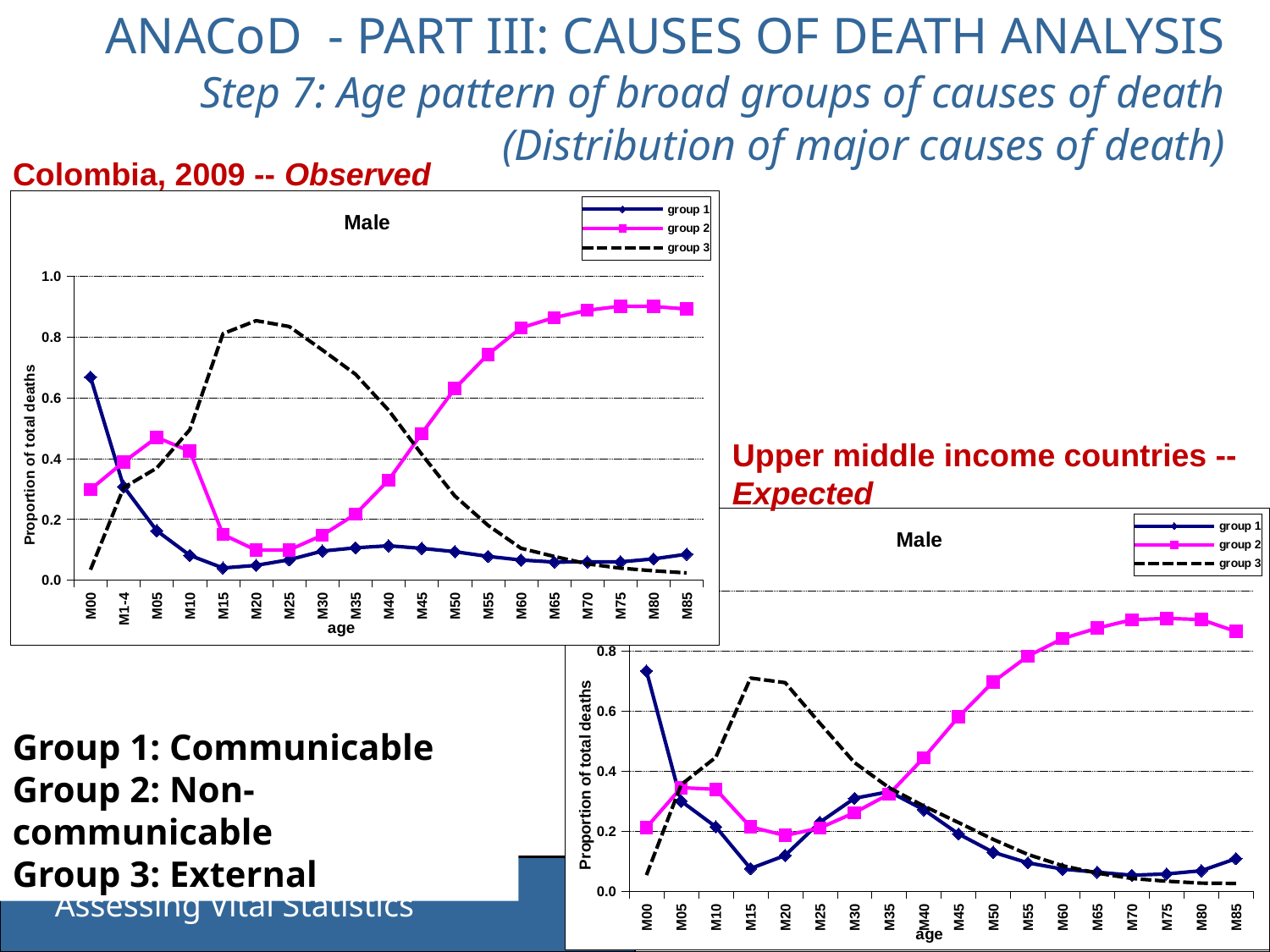
How many series does the legend of the Colombia, 2009 -- Observed chart list? 3 In the Colombia, 2009 -- Observed chart, which series has the larger value at M20: group 2 or group 3? group 3 In the Upper middle income countries -- Expected chart, is the group 3 value at M15 greater or less than 0.6? greater In the Colombia, 2009 -- Observed chart, is the group 1 value at M00 greater or less than 0.6? greater What kind of chart is the Colombia, 2009 -- Observed chart? line chart In the Upper middle income countries -- Expected chart, does the group 2 series generally rise or fall from M25 to M75? rise In the Colombia, 2009 -- Observed chart, at which age category is the group 1 value highest? M00 What is the y-axis label of the Colombia, 2009 -- Observed chart? Proportion of total deaths In the Colombia, 2009 -- Observed chart, is the group 2 value at M85 greater or less than 0.8? greater In the Upper middle income countries -- Expected chart, which series has the larger value at M60: group 1 or group 2? group 2 How many age categories are shown on the x axis of the Upper middle income countries -- Expected chart? 18 How many age categories are shown on the x axis of the Colombia, 2009 -- Observed chart? 19